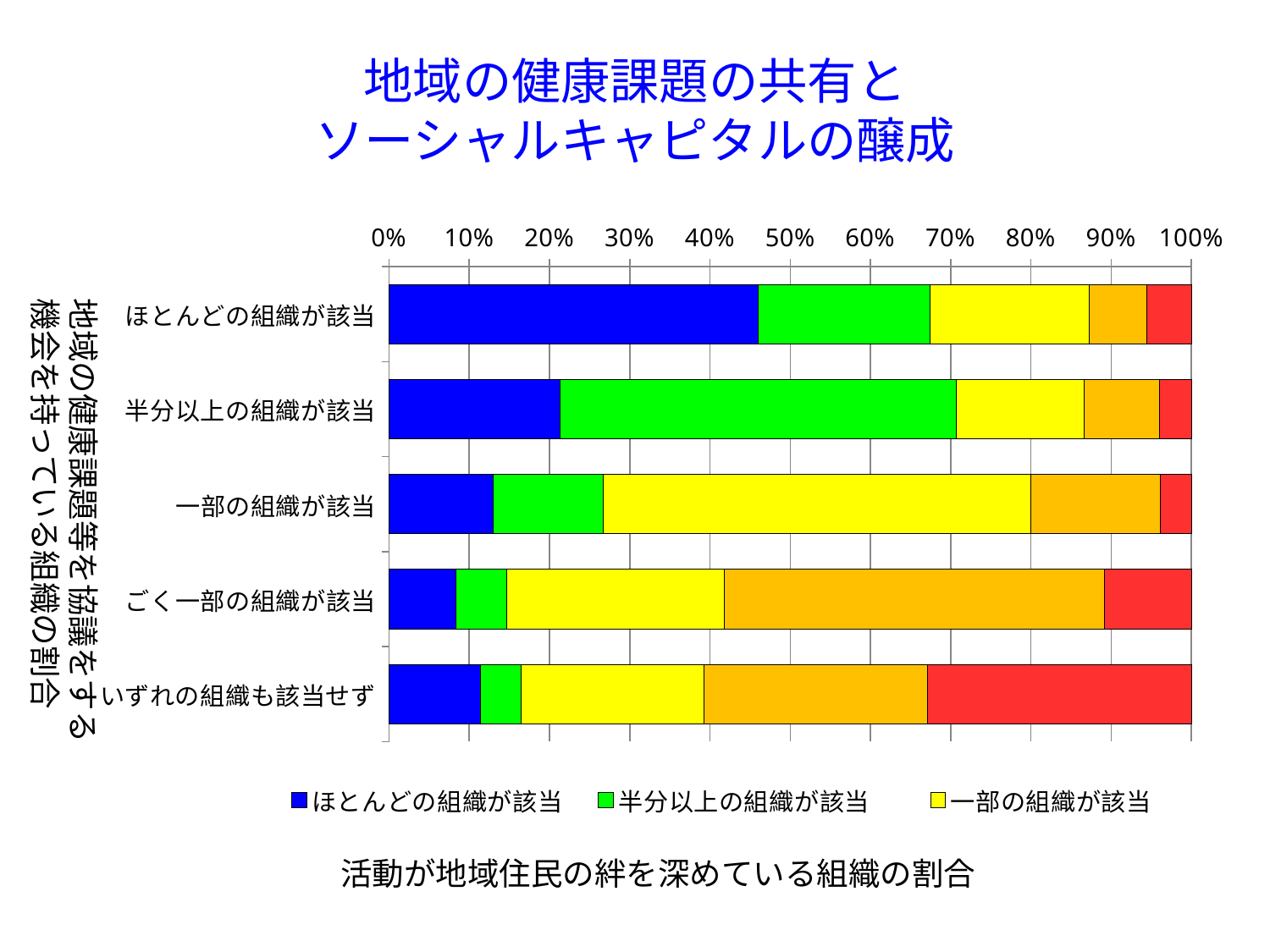
Which is larger: the 半分以上の組織が該当 (green) segment for the category 半分以上の組織が該当 or for the category ほとんどの組織が該当? 半分以上の組織が該当 What is the label of the horizontal axis of the chart? 活動が地域住民の絆を深めている組織の割合 Which category has the largest 半分以上の組織が該当 (green) segment? 半分以上の組織が該当 Is the ほとんどの組織が該当 (blue) segment for the category ごく一部の組織が該当 greater or less than 20%? less How many series does the chart's legend list? 3 Is the 半分以上の組織が該当 (green) segment for the category 半分以上の組織が該当 greater or less than 40%? greater How many categories are shown on the vertical axis of the chart? 5 Which category has the largest ほとんどの組織が該当 (blue) segment? ほとんどの組織が該当 Is the ほとんどの組織が該当 (blue) segment for the category ほとんどの組織が該当 greater or less than 40%? greater Which category has the largest 一部の組織が該当 (yellow) segment? 一部の組織が該当 What kind of chart is shown on the slide? Stacked bar chart